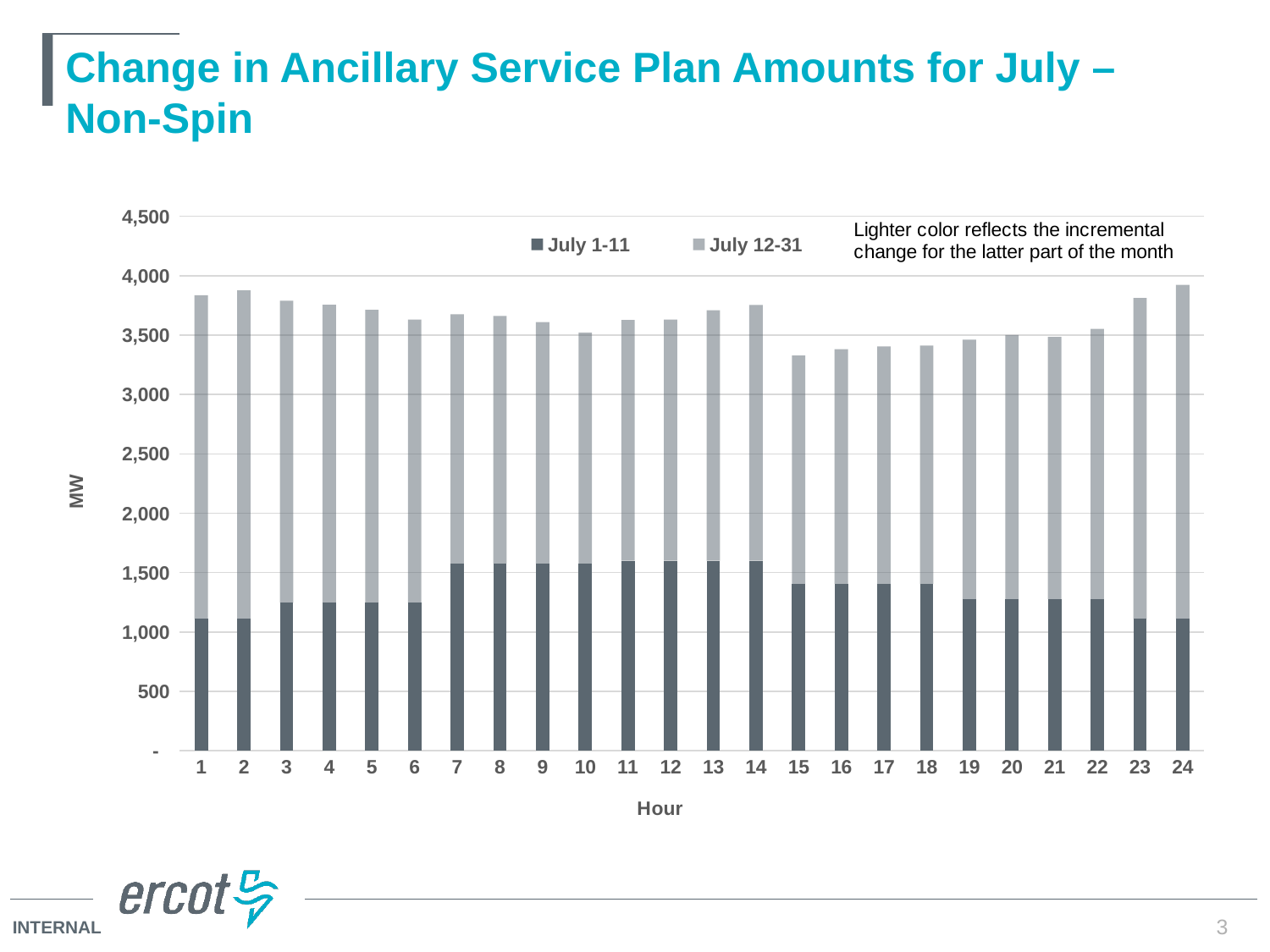
Is the July 1-11 value for hour 15 greater or less than 1,500? less Is the July 1-11 value for hour 7 greater or less than 1,500? greater Which hour has the lowest total stacked bar? 15 How many series does the legend list? 2 Which is larger, the July 1-11 value for hour 7 or for hour 1? Hour 7 What are the two series named in the legend? July 1-11 and July 12-31 How many hours (categories) are plotted along the x axis? 24 Is the total stacked value for hour 15 greater or less than 3,500? less What kind of chart is shown on the slide? Stacked bar chart From hour 15 to hour 24, do the total stacked values generally rise or fall? Rise What unit is shown on the y axis label? MW